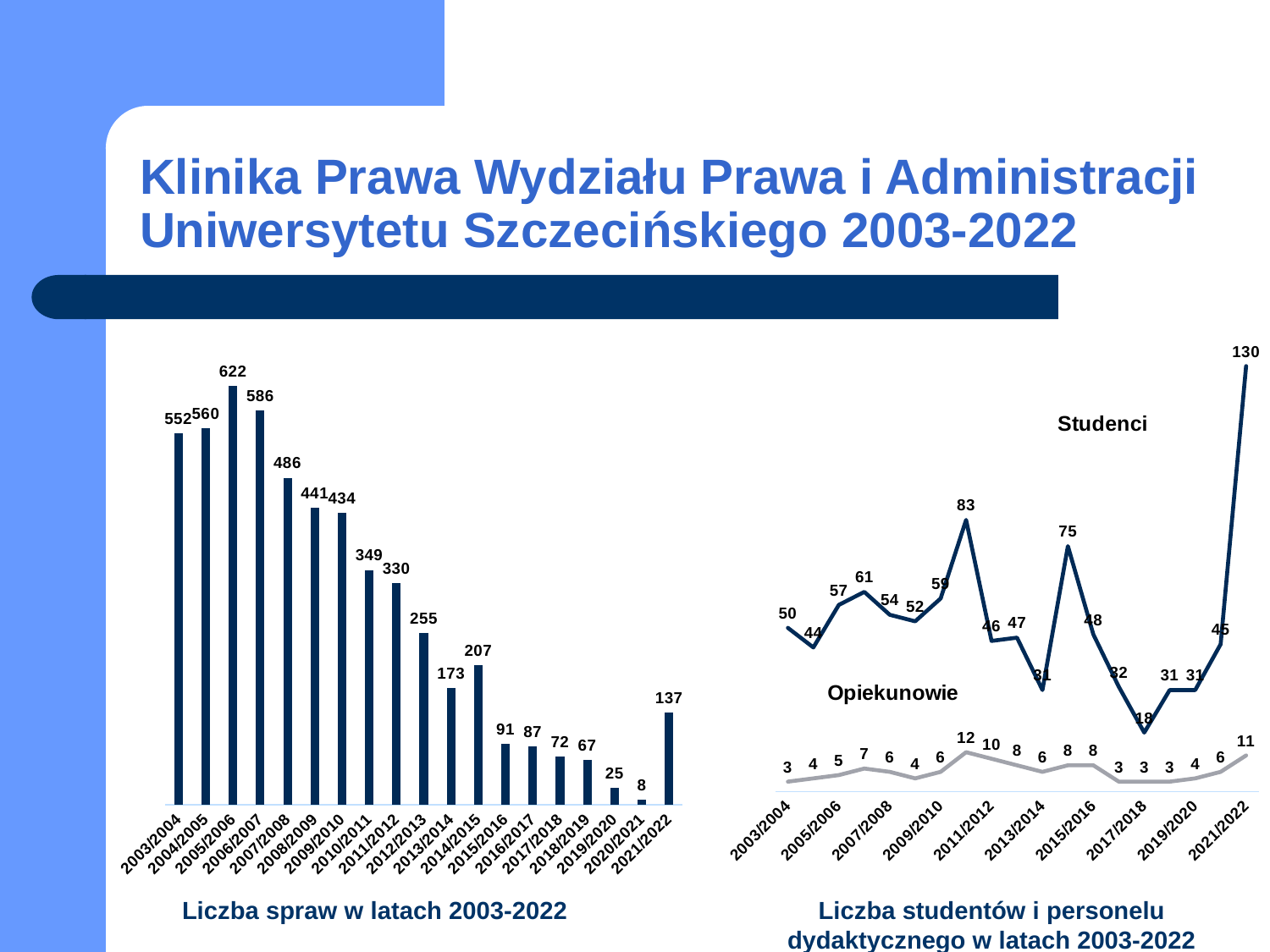
In the left chart 'Liczba spraw w latach 2003-2022', which year has the highest value? 2005/2006 In the left chart 'Liczba spraw w latach 2003-2022', which year has the lowest value? 2020/2021 What type of chart is the right chart, 'Liczba studentów i personelu dydaktycznego w latach 2003-2022'? line chart In the right chart 'Liczba studentów i personelu dydaktycznego w latach 2003-2022', what is the value of the Opiekunowie series for 2021/2022? 11 In the left chart 'Liczba spraw w latach 2003-2022', how many years (bars) are shown? 19 In the left chart 'Liczba spraw w latach 2003-2022', what is the difference between the values for 2003/2004 and 2004/2005? 8 What type of chart is the left chart, 'Liczba spraw w latach 2003-2022'? bar chart In the left chart 'Liczba spraw w latach 2003-2022', what is the value for 2021/2022? 137 In the left chart 'Liczba spraw w latach 2003-2022', what is the value for 2005/2006? 622 How many series are plotted in the right chart 'Liczba studentów i personelu dydaktycznego w latach 2003-2022'? 2 In the left chart 'Liczba spraw w latach 2003-2022', which is larger, the value for 2013/2014 or 2014/2015? 2014/2015 In the right chart 'Liczba studentów i personelu dydaktycznego w latach 2003-2022', what is the highest value of the Studenci series? 130